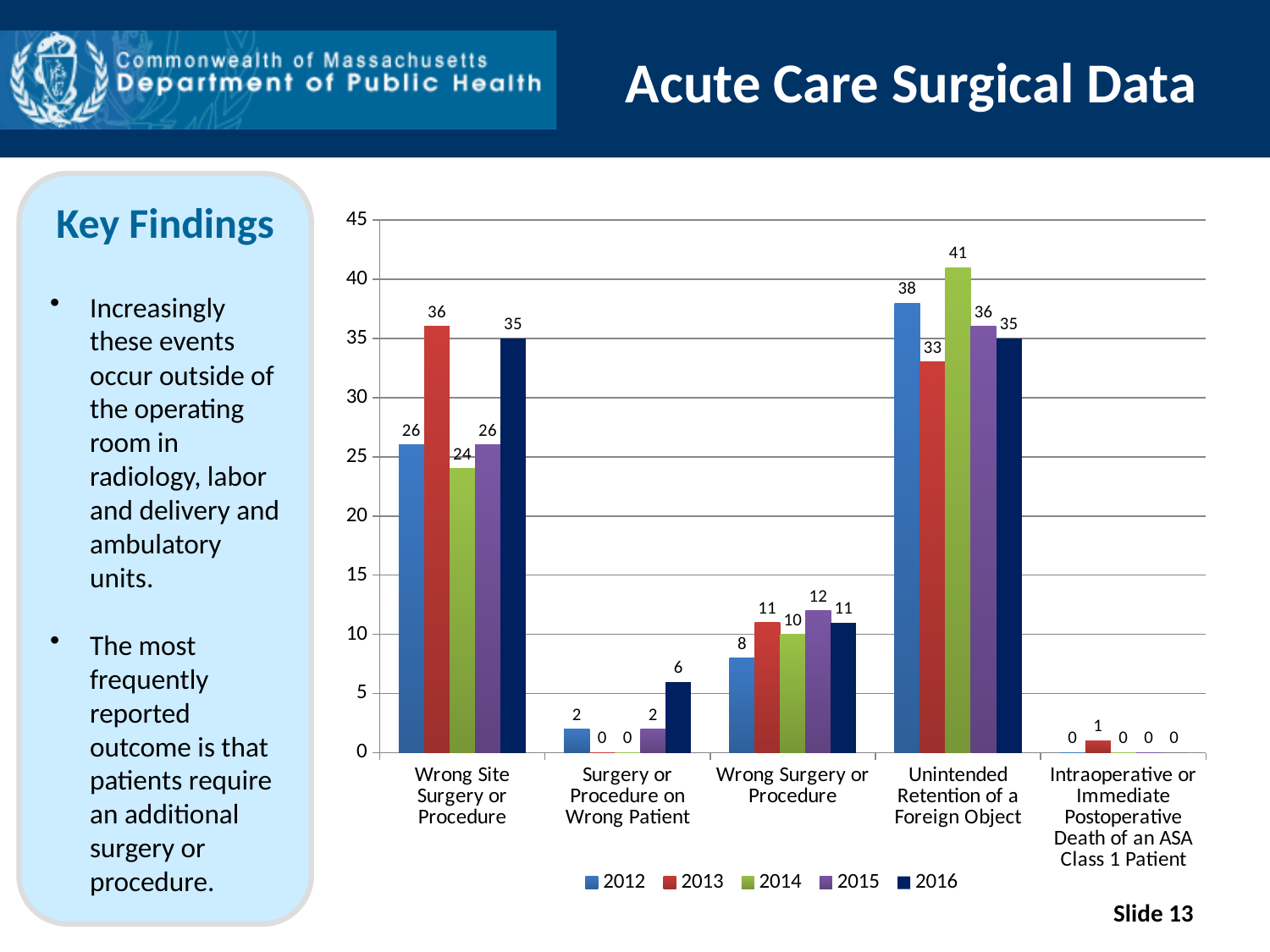
Which year is shown in the legend with the dark navy colour? 2016 Which is larger for Wrong Surgery or Procedure: the 2012 value or the 2015 value? 2015 How many categories are shown on the x axis? 5 What is the total of the five yearly values for Intraoperative or Immediate Postoperative Death of an ASA Class 1 Patient? 1 How many series does the legend list? 5 What kind of chart is shown on the slide? Bar chart What is the difference between the 2013 and 2014 values for Wrong Site Surgery or Procedure? 12 What is the value for Wrong Site Surgery or Procedure in 2013? 36 Which year has the highest value for Unintended Retention of a Foreign Object? 2014 What is the value for Unintended Retention of a Foreign Object in 2014? 41 Which year has the lowest value for Wrong Site Surgery or Procedure? 2014 What is the value for Surgery or Procedure on Wrong Patient in 2016? 6